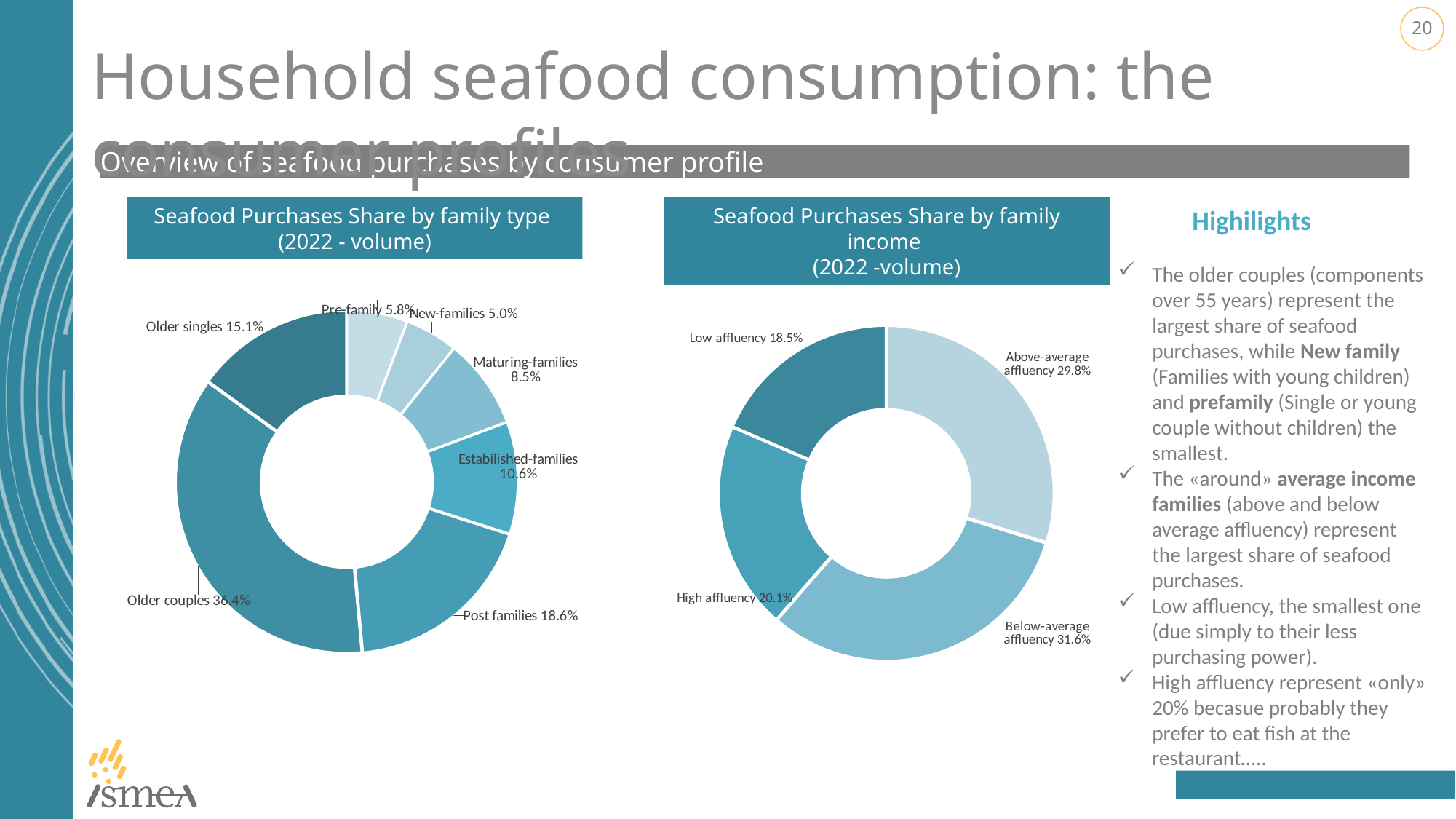
In the 'Seafood Purchases Share by family income' chart, what is the difference between Below-average affluency and Above-average affluency? 1.8% In the 'Seafood Purchases Share by family income' chart, which income group has the smallest share? Low affluency In the 'Seafood Purchases Share by family income' chart, what share does Below-average affluency have? 31.6% In the 'Seafood Purchases Share by family type' chart, how many family types are shown? 7 In the 'Seafood Purchases Share by family type' chart, what is the difference between the shares of Post families and Older singles? 3.5% In the 'Seafood Purchases Share by family type' chart, which family type has the smallest share? New-families What kind of chart is the 'Seafood Purchases Share by family type' chart? Doughnut (pie) chart In the 'Seafood Purchases Share by family income' chart, how many income groups are shown? 4 What year do both charts on the slide refer to? 2022 In the 'Seafood Purchases Share by family income' chart, which is larger: Above-average affluency or High affluency? Above-average affluency In the 'Seafood Purchases Share by family type' chart, what share do Older couples have? 36.4% In the 'Seafood Purchases Share by family type' chart, which family type has the largest share? Older couples